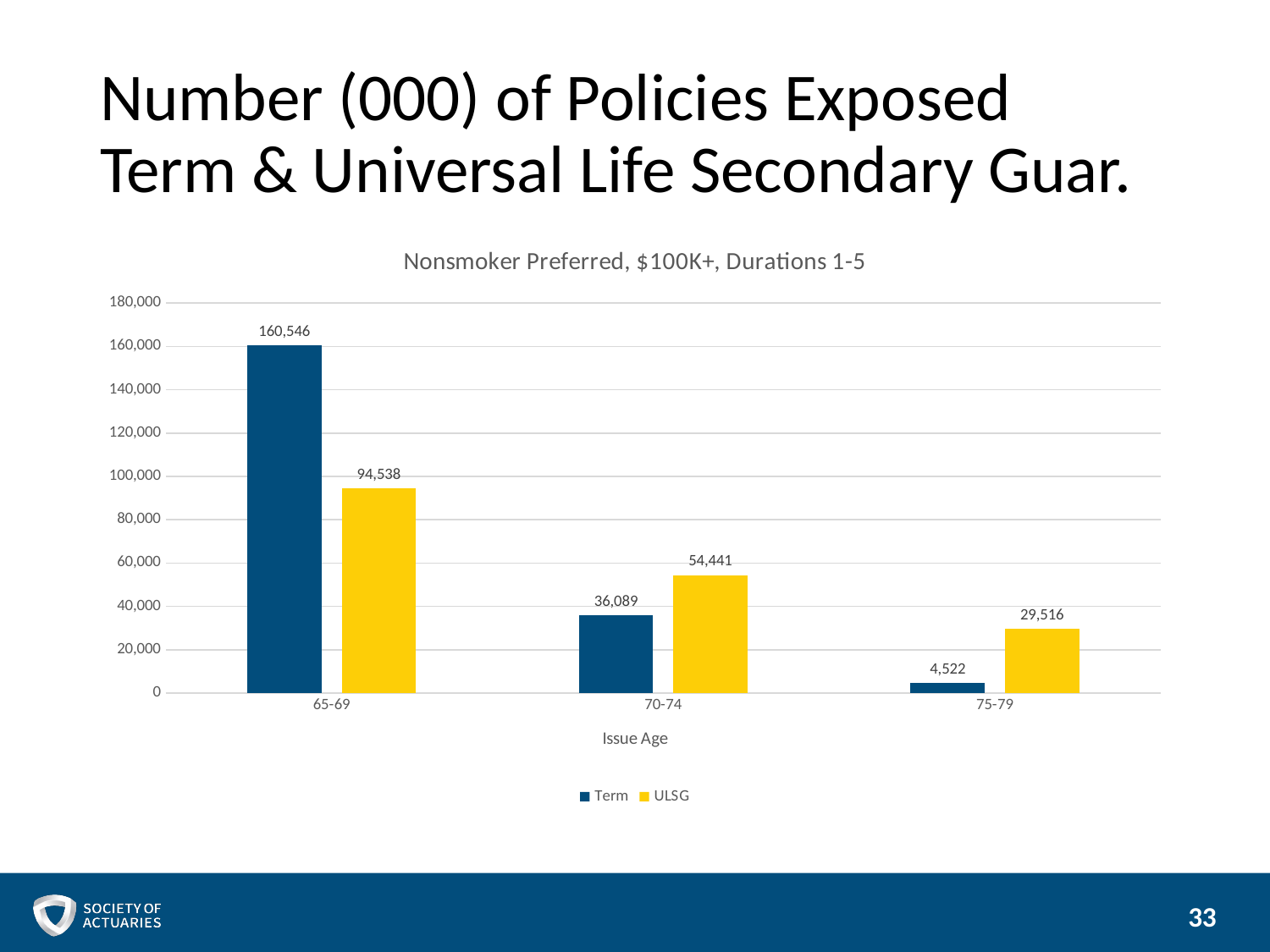
How many issue age groups are shown on the x axis? 3 How many series does the legend list? 2 What is the Term value for issue age 75-79? 4,522 Which issue age group has the highest ULSG value? 65-69 For issue age 70-74, which is larger, Term or ULSG? ULSG What kind of chart is shown on the slide? Bar chart Which issue age group has the lowest Term value? 75-79 What is the ULSG value for issue age 70-74? 54,441 Do the Term values rise or fall as issue age increases along the x axis? Fall What is the Term value for issue age 65-69? 160,546 What is the difference between the ULSG values for issue ages 70-74 and 75-79? 24,925 What is the difference between the Term and ULSG values for issue age 65-69? 66,008